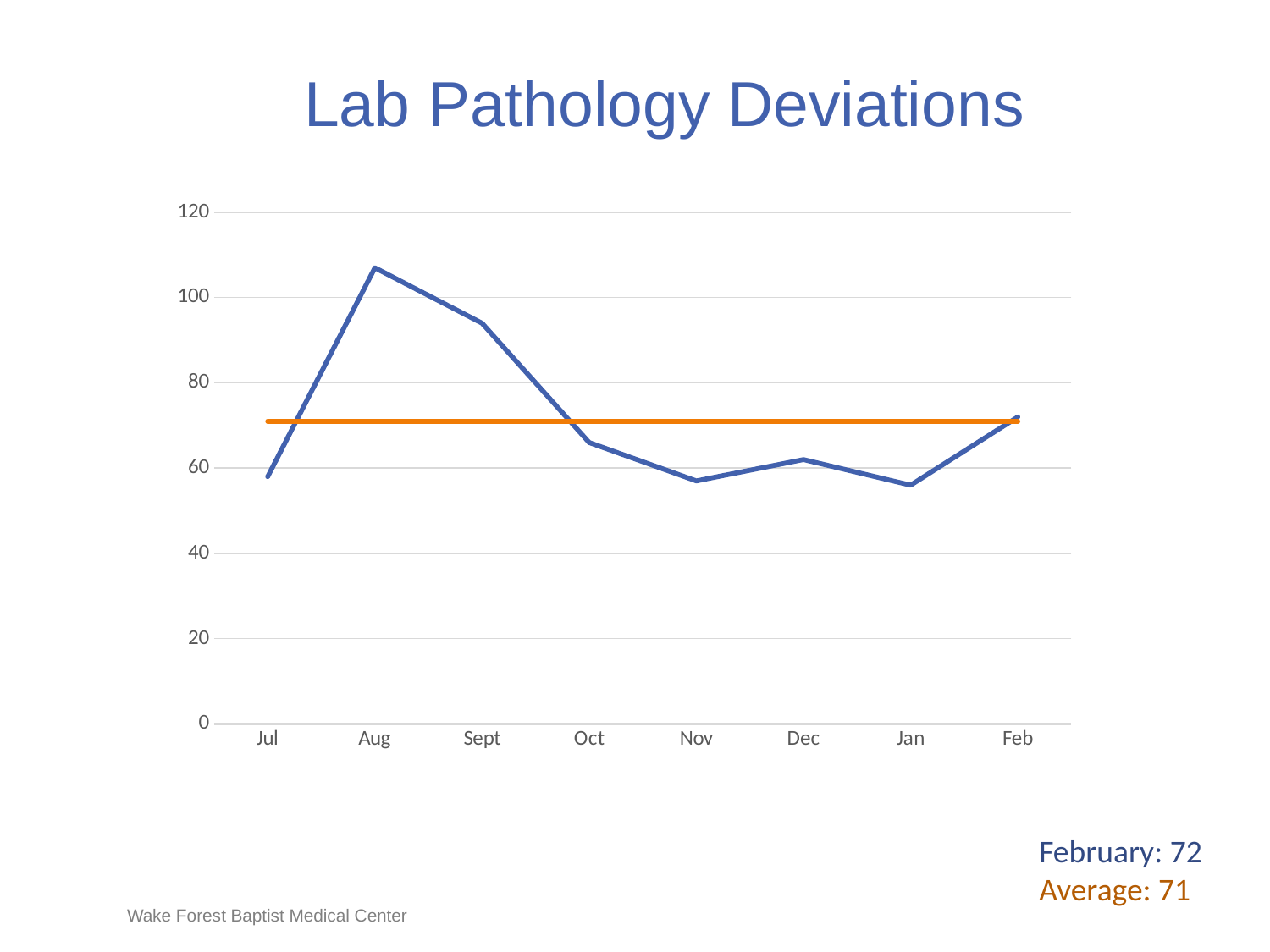
Which month has the highest number of deviations? Aug What is the title of the chart? Lab Pathology Deviations Do the values rise or fall from Aug to Nov? fall What kind of chart is shown on the slide? line chart How many months are plotted along the x axis? 8 Which is larger, the value for Aug or the value for Sept? Aug Is the value for Jul greater or less than 60? less Is the value for Nov greater or less than 60? less Is the value for Aug greater or less than 100? greater What is the average value shown by the horizontal orange line? 71 What is the value for February? 72